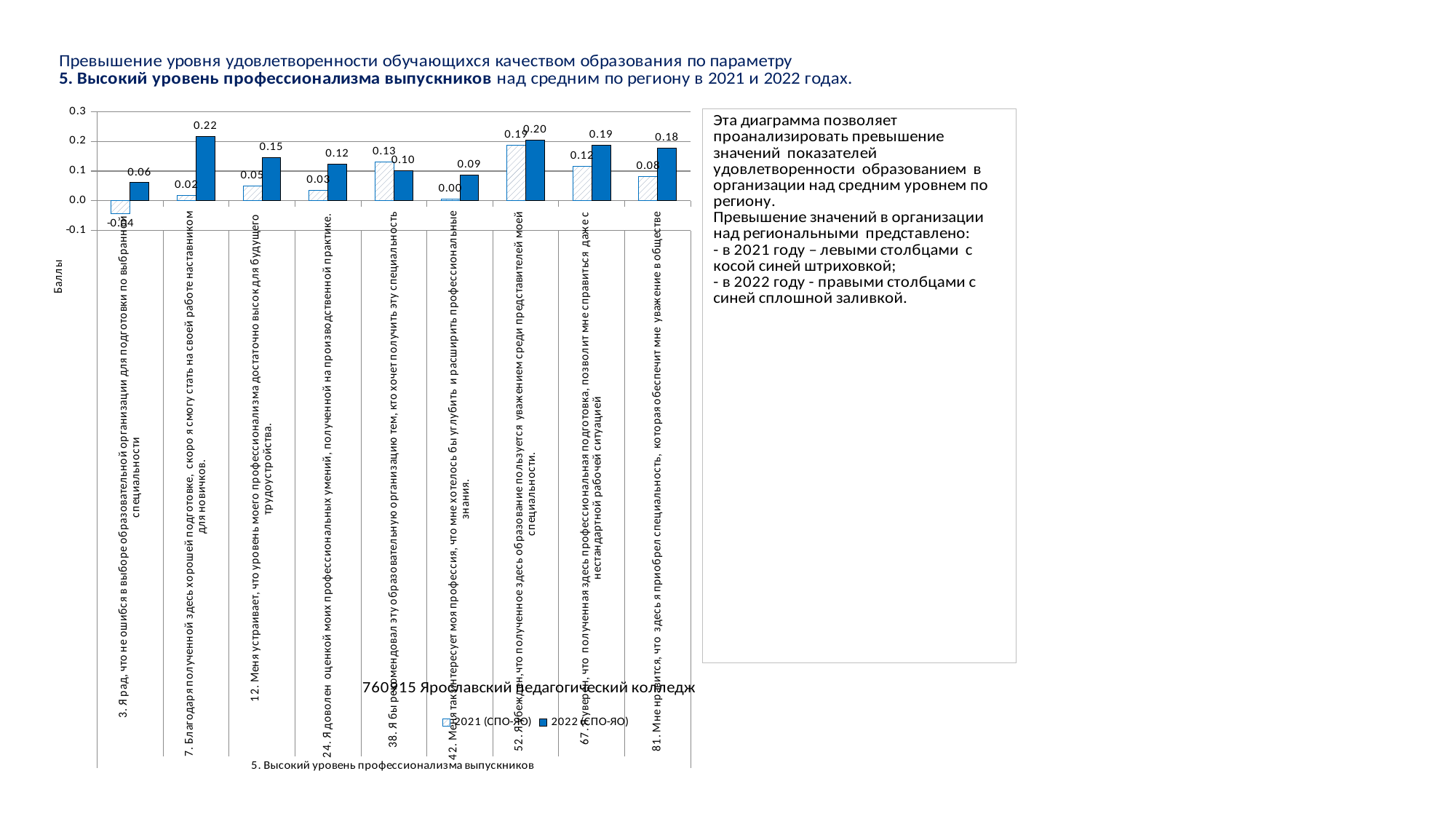
Which statement has the highest 2022 (СПО-ЯО) value? 7. Благодаря полученной здесь хорошей подготовке, скоро я смогу стать на своей работе наставником для новичков. What type of chart is shown on the slide? Bar chart For statement 38, which series has the larger value, 2021 (СПО-ЯО) or 2022 (СПО-ЯО)? 2021 (СПО-ЯО) For statement 81, what is the difference between the 2022 (СПО-ЯО) and 2021 (СПО-ЯО) values? 0.10 How many series does the chart legend list? 2 How many statements (categories) are shown on the x axis of the chart? 9 Which statement has the highest 2021 (СПО-ЯО) value? 52. Я убежден, что полученное здесь образование пользуется уважением среди представителей моей специальности. What is the 2021 (СПО-ЯО) value for statement 38 (Я бы рекомендовал эту образовательную организацию...)? 0.13 Which statement has the lowest 2021 (СПО-ЯО) value? 3. Я рад, что не ошибся в выборе образовательной организации для подготовки по выбранной специальности For statement 7, how much higher is the 2022 (СПО-ЯО) value than the 2021 (СПО-ЯО) value? 0.20 What is the 2022 (СПО-ЯО) value for statement 7 (Благодаря полученной здесь хорошей подготовке...)? 0.22 What is the 2021 (СПО-ЯО) value for statement 42 (Меня так интересует моя профессия...)? 0.00